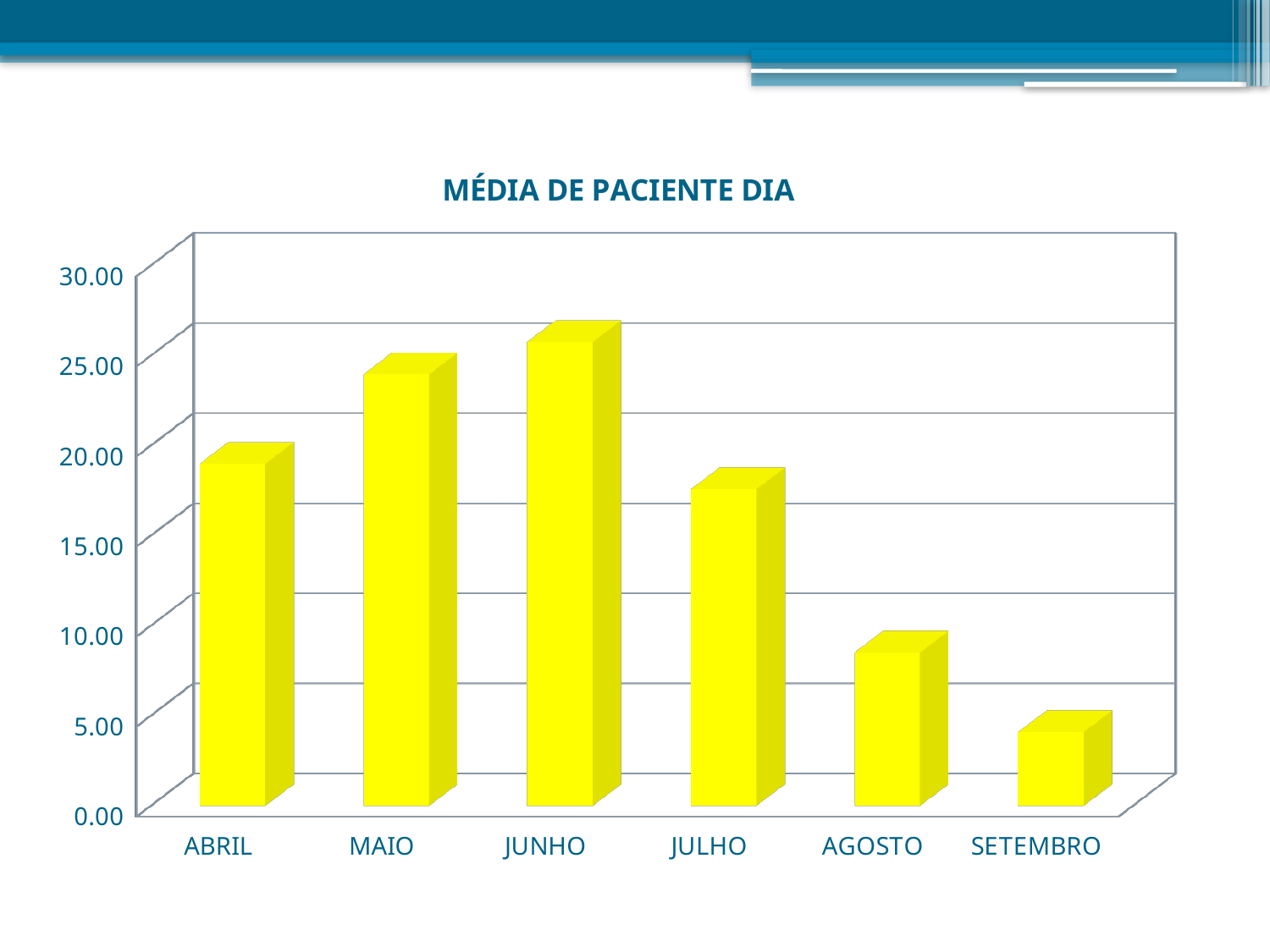
Which is larger, the value for MAIO or the value for JULHO? MAIO How many months are shown on the x axis of the chart? 6 Which month has the highest value in the chart? JUNHO Is the value for ABRIL greater or less than 15.00? greater Do the values rise or fall from JUNHO to SETEMBRO? fall What is the title of the chart? MÉDIA DE PACIENTE DIA Which month has the lowest value in the chart? SETEMBRO What kind of chart is shown on the slide? Bar chart Which is larger, the value for AGOSTO or the value for ABRIL? ABRIL Is the value for SETEMBRO greater or less than 10.00? less Is the value for MAIO greater or less than 20.00? greater